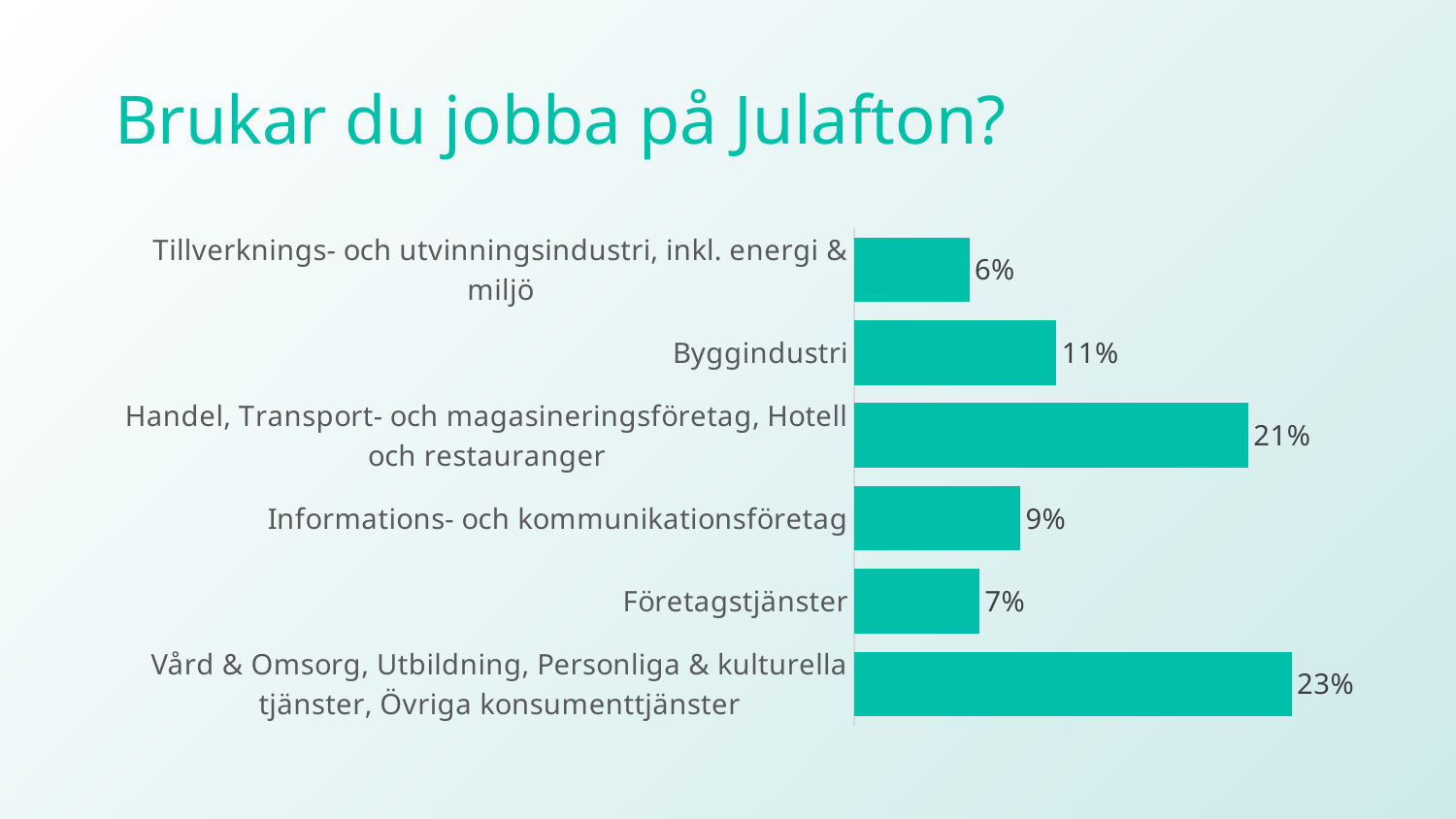
What is the value for Företagstjänster? 7% What is the value for Informations- och kommunikationsföretag? 9% What is the title of the slide? Brukar du jobba på Julafton? How many categories are shown in the chart? 6 What is the value for Byggindustri? 11% What is the value for Tillverknings- och utvinningsindustri, inkl. energi & miljö? 6% What is the difference between the values for Vård & Omsorg, Utbildning, Personliga & kulturella tjänster, Övriga konsumenttjänster and Tillverknings- och utvinningsindustri, inkl. energi & miljö? 17% What is the difference between the values for Handel, Transport- och magasineringsföretag, Hotell och restauranger and Byggindustri? 10% What kind of chart is shown on the slide? Bar chart Which category has the highest value? Vård & Omsorg, Utbildning, Personliga & kulturella tjänster, Övriga konsumenttjänster Which category has the lowest value? Tillverknings- och utvinningsindustri, inkl. energi & miljö Which is larger, the value for Informations- och kommunikationsföretag or the value for Företagstjänster? Informations- och kommunikationsföretag